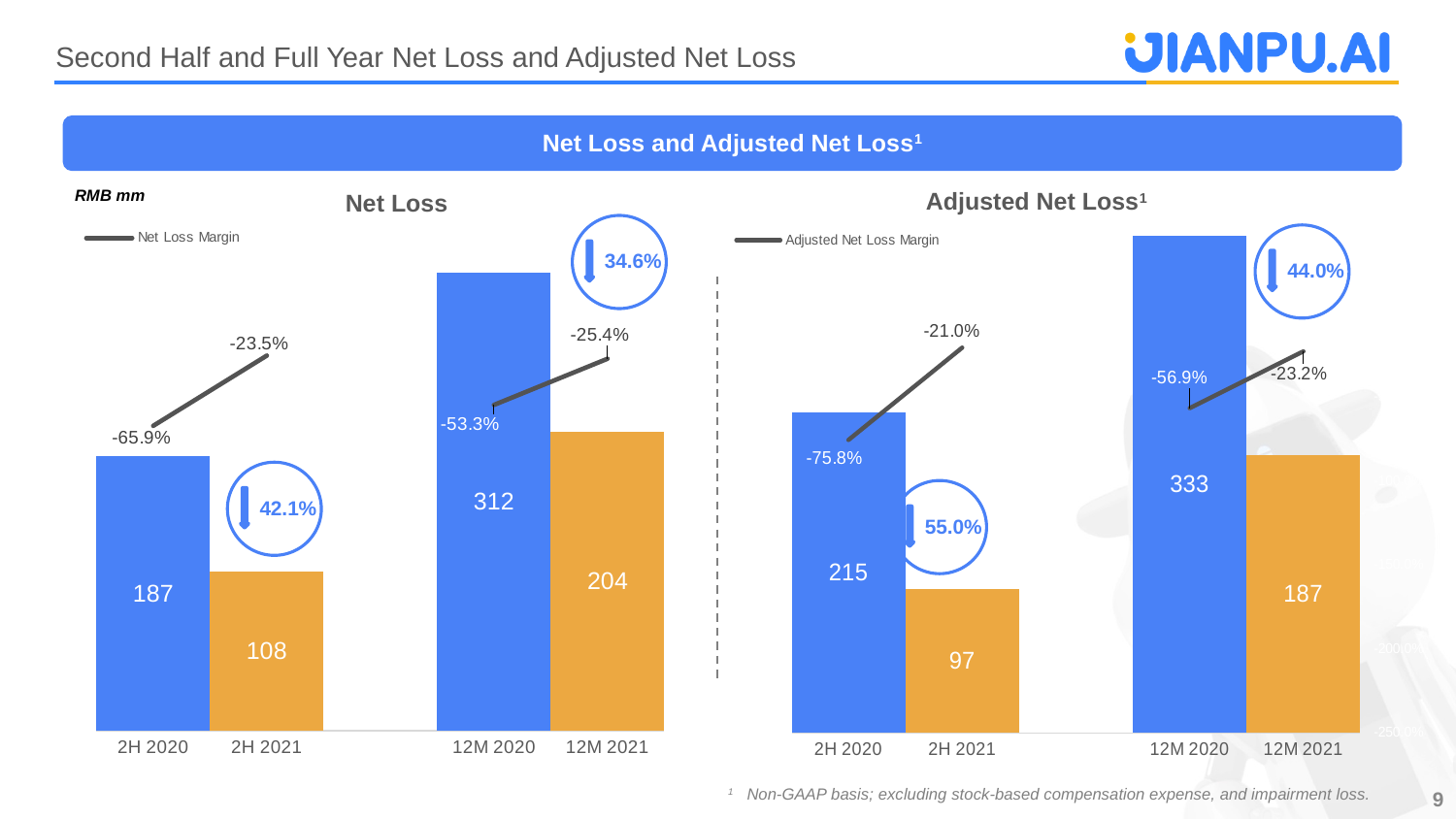
In the Adjusted Net Loss chart, what is the adjusted net loss margin for 12M 2021? -23.2% What type of chart is the Net Loss chart? Combination bar and line chart In the Net Loss chart, what is the net loss for 2H 2021? 108 In the Net Loss chart, what is the net loss margin for 2H 2020? -65.9% In the Net Loss chart, what is the net loss for 12M 2020? 312 In the Adjusted Net Loss chart, what is the adjusted net loss for 2H 2020? 215 In the Adjusted Net Loss chart, which period has the highest adjusted net loss? 12M 2020 In the Net Loss chart, which period has the lowest net loss? 2H 2021 In the Adjusted Net Loss chart, what is the difference between the adjusted net loss for 2H 2020 and 2H 2021? 118 In the Net Loss chart, what is the difference between the net loss for 12M 2020 and 12M 2021? 108 Which is larger: the 12M 2021 net loss in the Net Loss chart or the 12M 2021 adjusted net loss in the Adjusted Net Loss chart? 12M 2021 net loss (204) In the Adjusted Net Loss chart, what percentage decline is shown in the circle between 2H 2020 and 2H 2021? 55.0%